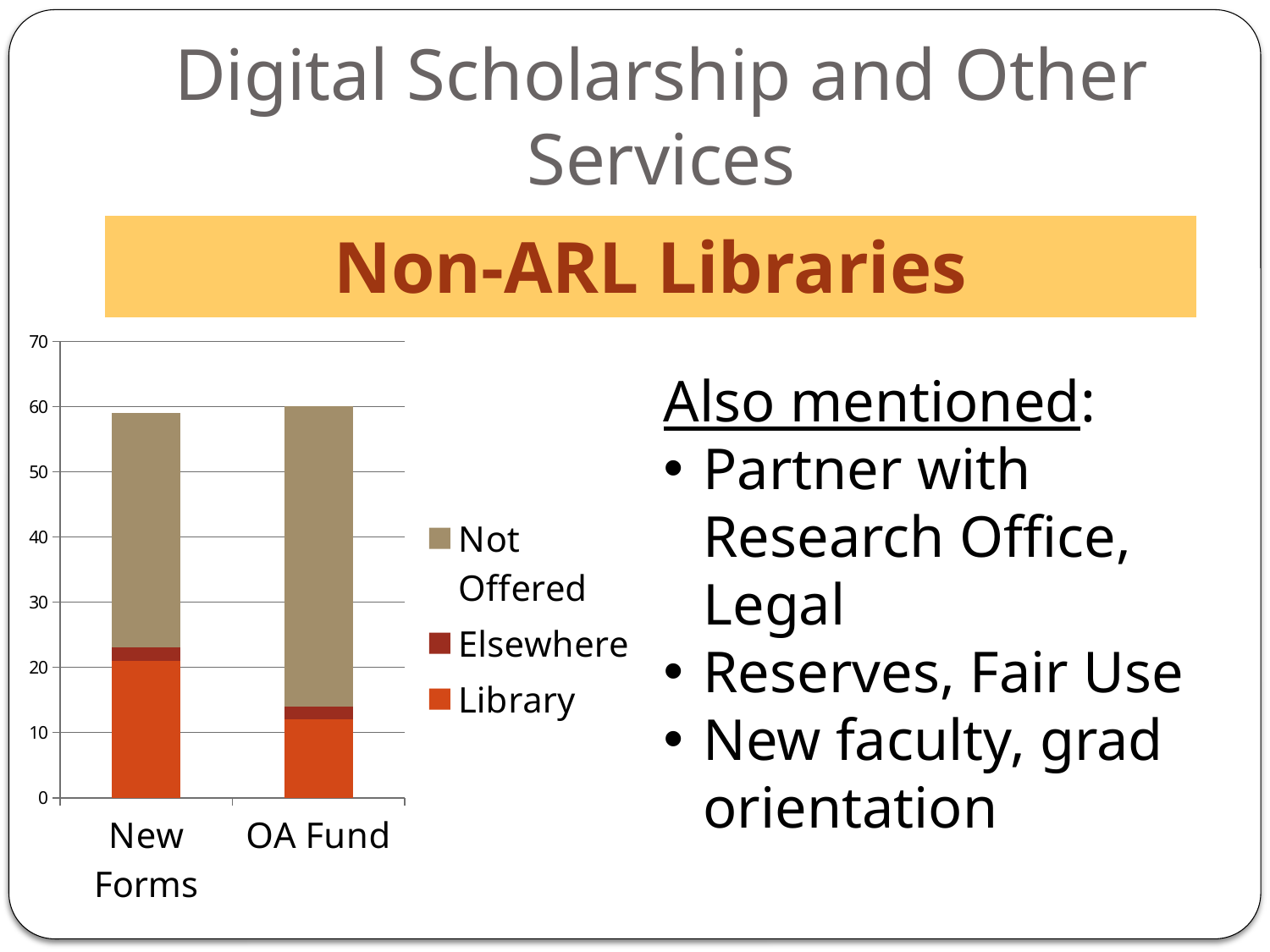
Which category has the larger Library segment, New Forms or OA Fund? New Forms Which series are listed in the chart's legend? Not Offered, Elsewhere, Library How many series does the chart's legend list? 3 How many categories are shown on the x axis of the chart? 2 Which series makes up the largest part of the OA Fund bar? Not Offered Is the total of the OA Fund bar greater or less than 50? greater What kind of chart is shown on the slide? Stacked bar chart Is the Library value for New Forms greater or less than 10? greater Is the Library value for OA Fund greater or less than 20? less Which series makes up the smallest part of the New Forms bar? Elsewhere What are the two categories on the x axis of the chart? New Forms, OA Fund